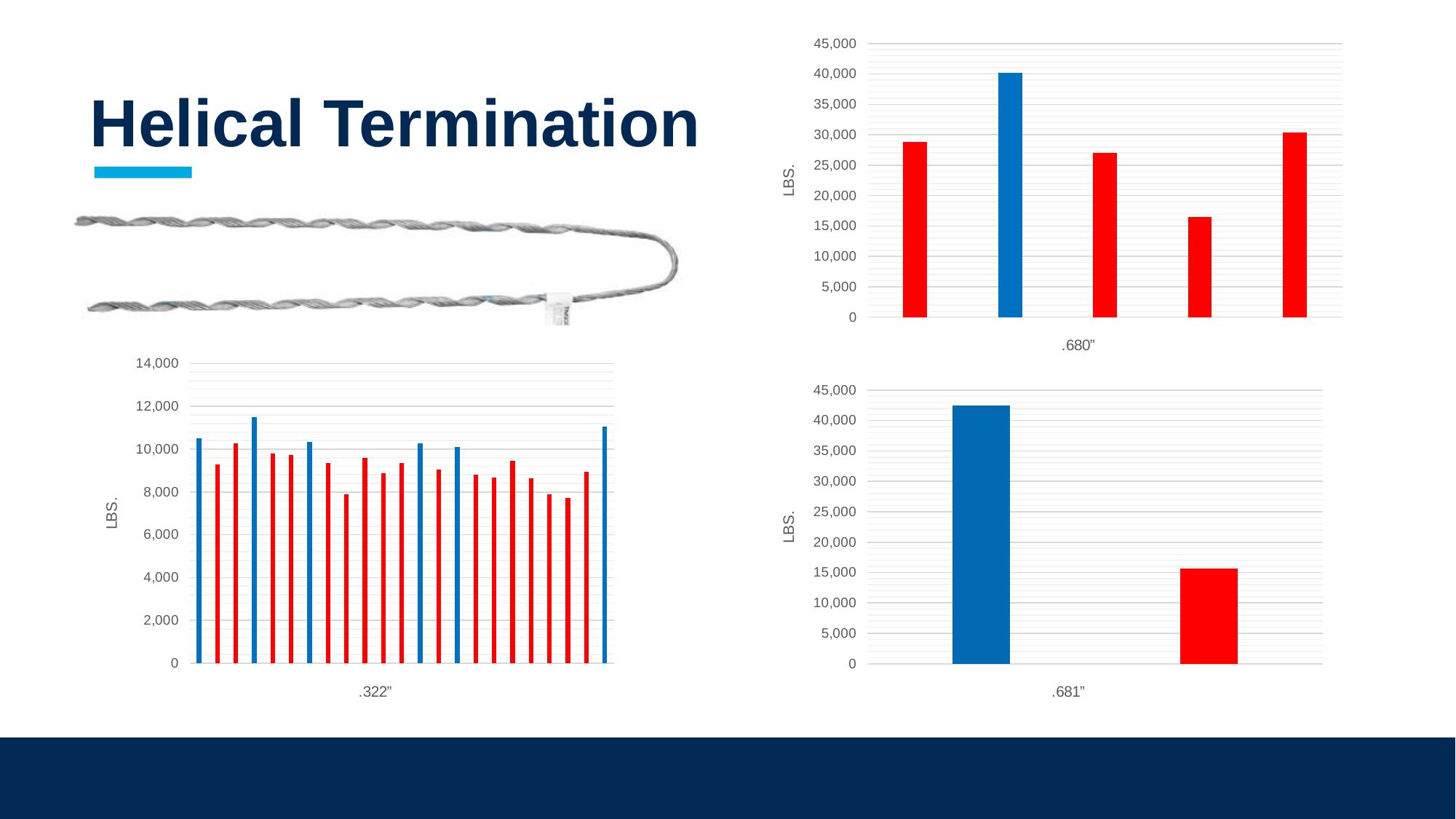
In the chart labelled .681", is the red bar greater or less than 20,000? less In the chart labelled .680", which bar is the tallest? the second bar (blue) How many bars are plotted in the chart labelled .680"? 5 What kind of chart is the chart labelled .681"? bar chart In the chart labelled .681", is the blue bar greater or less than 40,000? greater In the chart labelled .680", is the blue bar greater or less than 35,000? greater How many bars are plotted in the chart labelled .681"? 2 In the chart labelled .680", which bar is the shortest? the fourth bar In the chart labelled .681", which bar is taller, the blue bar or the red bar? the blue bar What is the label on the vertical axis of the chart labelled .322"? LBS.